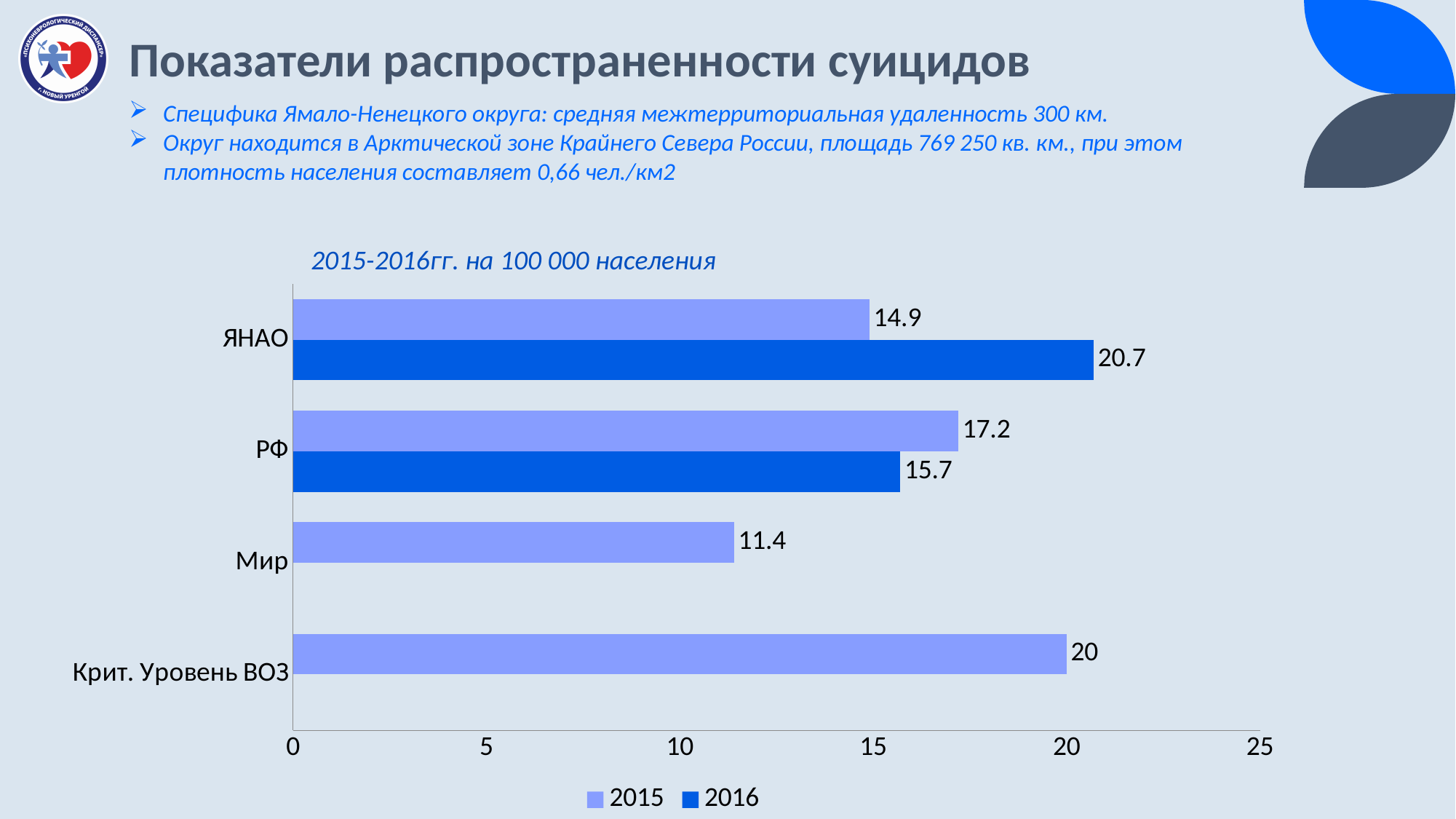
What is the difference between the 2016 and 2015 values for ЯНАО? 5.8 How many series does the legend list? 2 What is the 2015 value for Мир? 11.4 Which is larger for РФ: the 2015 value or the 2016 value? 2015 What is the title of the chart? 2015-2016гг. на 100 000 населения What kind of chart is shown on the slide? Bar chart What is the value shown for Крит. Уровень ВОЗ? 20 How many categories are shown on the y axis? 4 What is the 2015 value for РФ? 17.2 Which category has the highest 2015 value? Крит. Уровень ВОЗ What is the 2016 value for ЯНАО? 20.7 Which category has the lowest 2015 value? Мир